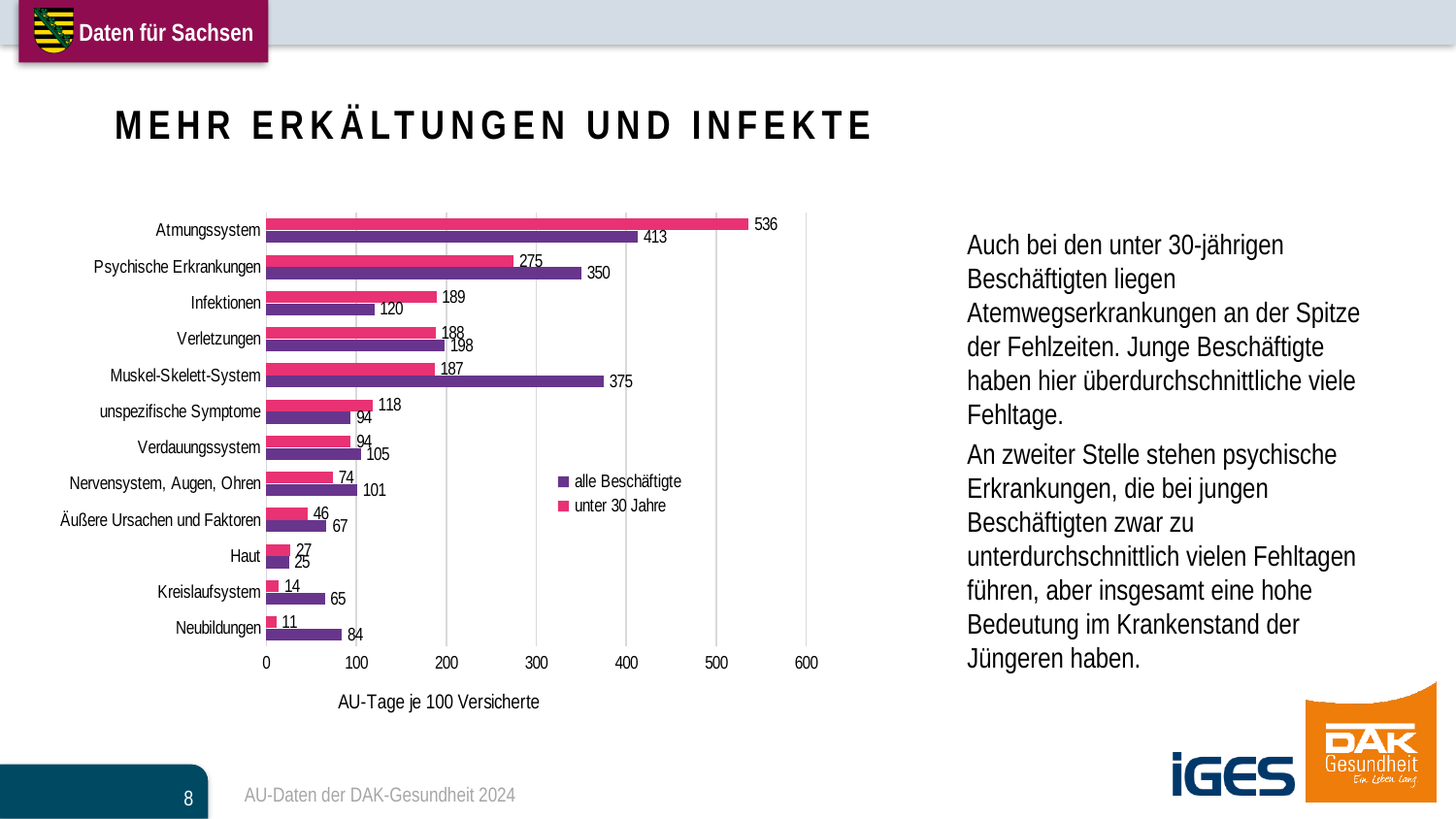
What is the difference between the 'unter 30 Jahre' and 'alle Beschäftigte' values for Atmungssystem? 123 How many categories are shown on the chart? 12 What kind of chart is shown on the slide? Bar chart What is the value for 'alle Beschäftigte' in the Muskel-Skelett-System category? 375 Which category has the lowest value for 'unter 30 Jahre'? Neubildungen What is the value for 'alle Beschäftigte' in the Psychische Erkrankungen category? 350 For Kreislaufsystem, which series has the larger value: 'alle Beschäftigte' or 'unter 30 Jahre'? alle Beschäftigte What is the label of the horizontal axis of the chart? AU-Tage je 100 Versicherte How many series does the legend list? 2 What is the value for 'unter 30 Jahre' in the Atmungssystem category? 536 For Infektionen, which series has the larger value: 'alle Beschäftigte' or 'unter 30 Jahre'? unter 30 Jahre Which category has the highest value for 'unter 30 Jahre'? Atmungssystem